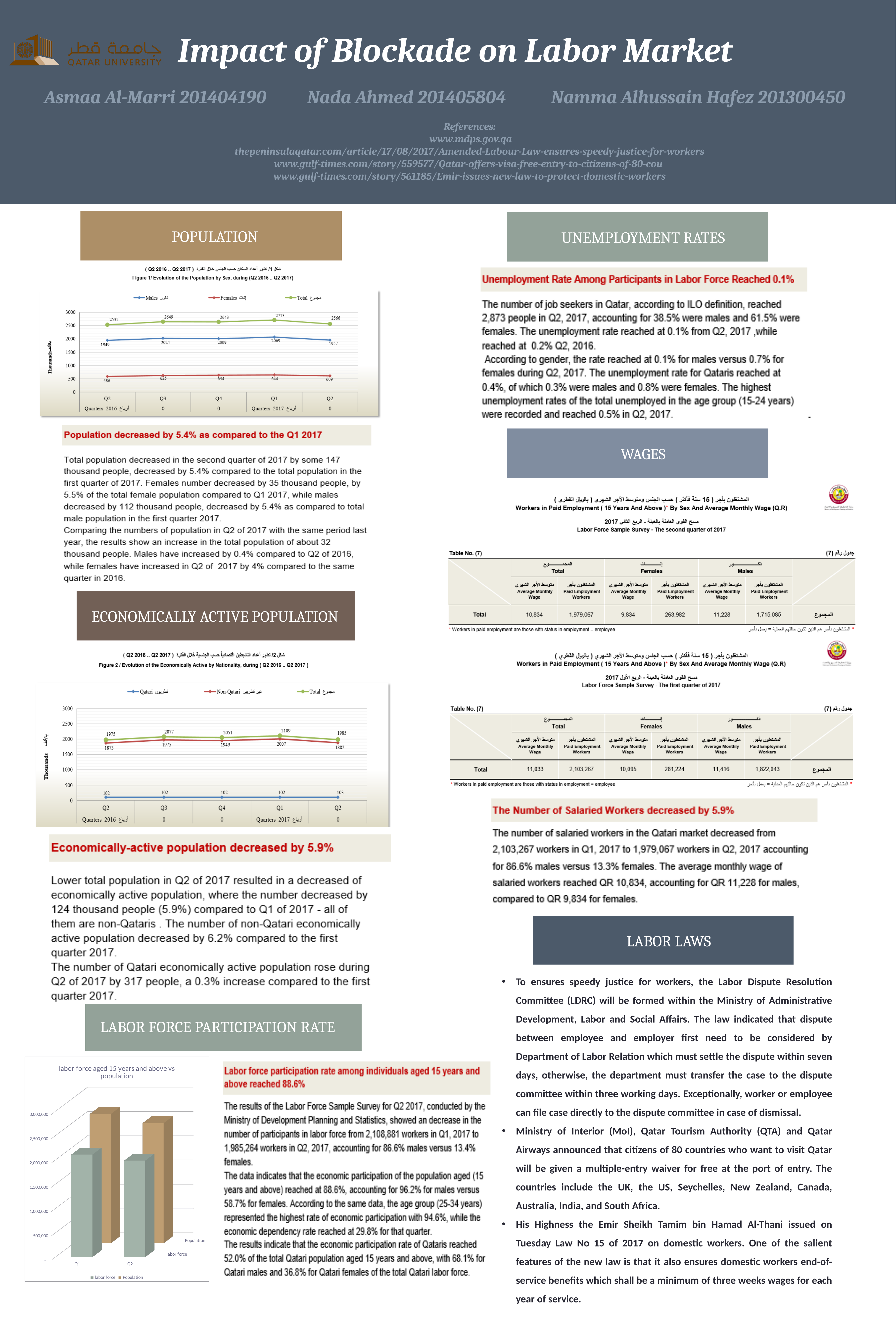
In Figure 2 (Evolution of the Economically Active by Nationality), how many quarters are plotted on the x axis? 5 In the chart 'labor force aged 15 years and above vs population', is the Population value for Q1 greater or less than 2,500,000? greater In Figure 1 (Evolution of the Population by Sex), how many series does the legend list? 3 In Figure 2 (Evolution of the Economically Active by Nationality), what is the Qatari value for Q2 2017? 103 In Figure 1 (Evolution of the Population by Sex), what is the difference between the Total values for Q1 2017 and Q2 2017? 147 In Figure 2 (Evolution of the Economically Active by Nationality), what is the Non-Qatari value for Q1 2017? 2007 In Figure 2 (Evolution of the Economically Active by Nationality), in which quarter is the Total series lowest? Q2 2016 In Figure 2 (Evolution of the Economically Active by Nationality), which is larger: the Total for Q3 2016 or the Total for Q4 2016? Q3 2016 In Figure 1 (Evolution of the Population by Sex), what is the Females value for Q2 2016? 586 In Figure 1 (Evolution of the Population by Sex), what is the Total value for Q1 2017? 2713 In Figure 1 (Evolution of the Population by Sex), in which quarter is the Males series highest? Q1 2017 In the chart 'labor force aged 15 years and above vs population', what kind of chart is it? bar chart